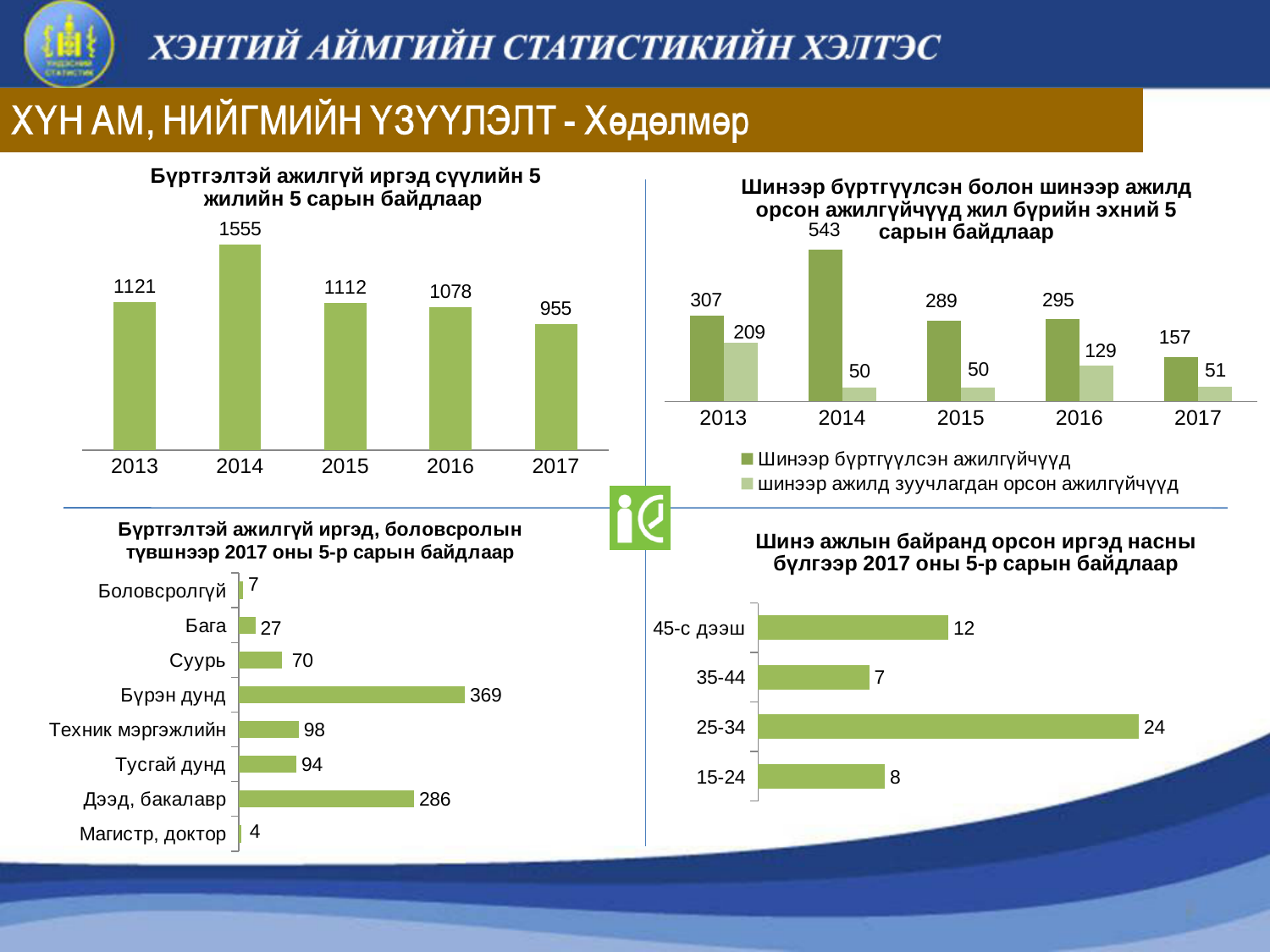
What kind of chart is the bottom-right chart (Шинэ ажлын байранд орсон иргэд насны бүлгээр 2017 оны 5-р сарын байдлаар)? Bar chart In the top-left chart (Бүртгэлтэй ажилгүй иргэд сүүлийн 5 жилийн 5 сарын байдлаар), what is the difference between the 2013 and 2017 values? 166 How many categories are shown in the bottom-left chart (Бүртгэлтэй ажилгүй иргэд, боловсролын түвшнээр 2017 оны 5-р сарын байдлаар)? 8 In the top-right chart (Шинээр бүртгүүлсэн болон шинээр ажилд орсон ажилгүйчүүд), what is the value of Шинээр бүртгүүлсэн ажилгүйчүүд for 2014? 543 In the top-left chart (Бүртгэлтэй ажилгүй иргэд сүүлийн 5 жилийн 5 сарын байдлаар), which year has the lowest value? 2017 How many series does the legend of the top-right chart (Шинээр бүртгүүлсэн болон шинээр ажилд орсон ажилгүйчүүд) list? 2 In the top-right chart (Шинээр бүртгүүлсэн болон шинээр ажилд орсон ажилгүйчүүд), which is larger for 2013: Шинээр бүртгүүлсэн ажилгүйчүүд or шинээр ажилд зуучлагдан орсон ажилгүйчүүд? Шинээр бүртгүүлсэн ажилгүйчүүд In the bottom-right chart (Шинэ ажлын байранд орсон иргэд насны бүлгээр 2017 оны 5-р сарын байдлаар), which age group has the highest value? 25-34 In the bottom-left chart (Бүртгэлтэй ажилгүй иргэд, боловсролын түвшнээр 2017 оны 5-р сарын байдлаар), which category has the lowest value? Магистр, доктор In the top-left chart (Бүртгэлтэй ажилгүй иргэд сүүлийн 5 жилийн 5 сарын байдлаар), what is the value for 2014? 1555 In the top-right chart (Шинээр бүртгүүлсэн болон шинээр ажилд орсон ажилгүйчүүд), what is the value of шинээр ажилд зуучлагдан орсон ажилгүйчүүд for 2016? 129 In the bottom-left chart (Бүртгэлтэй ажилгүй иргэд, боловсролын түвшнээр 2017 оны 5-р сарын байдлаар), what is the value for Бүрэн дунд? 369